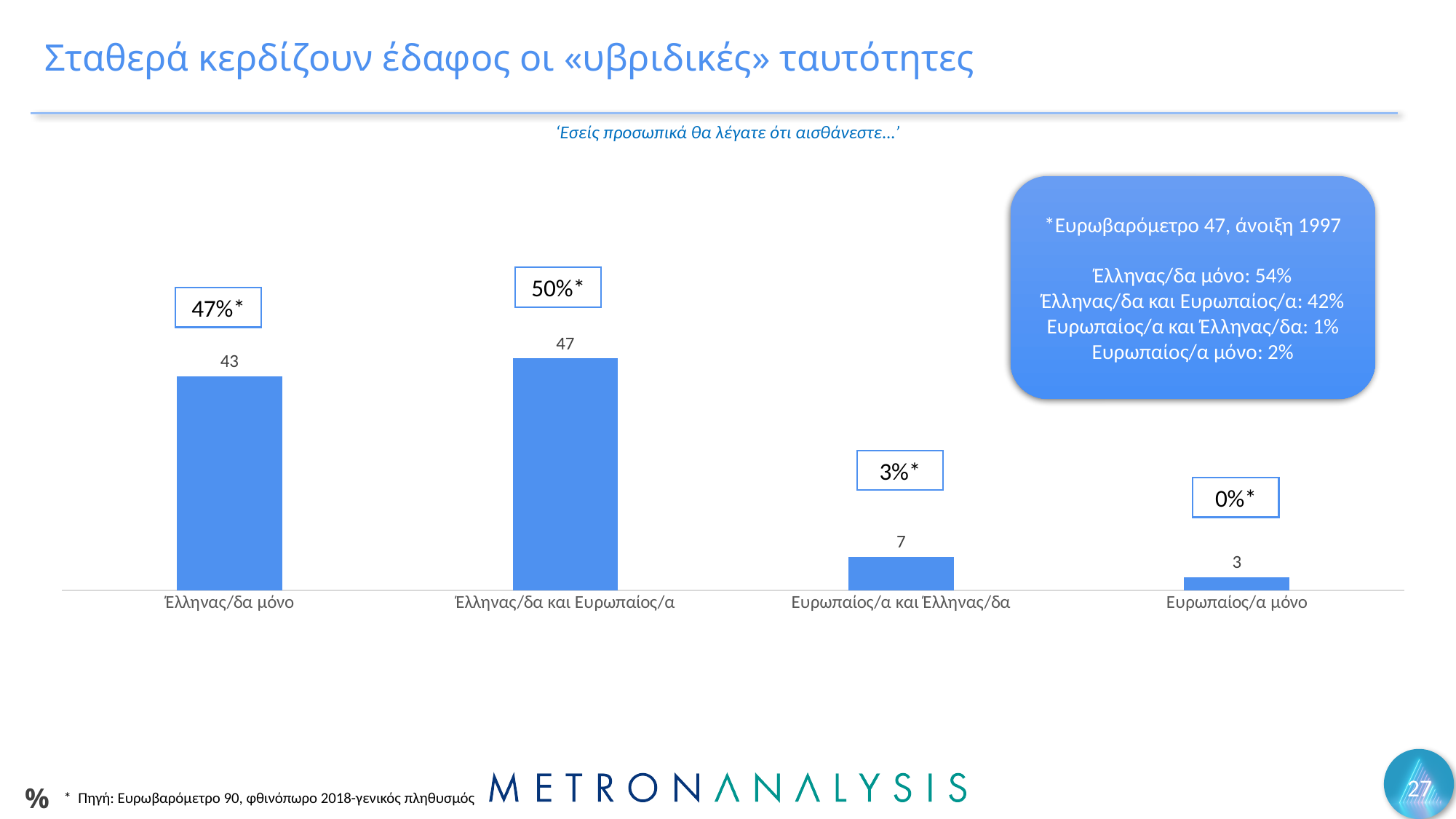
What is the difference between the values for Έλληνας/δα και Ευρωπαίος/α and Έλληνας/δα μόνο? 4 What is the starred label shown in the box above the bar for Έλληνας/δα και Ευρωπαίος/α? 50%* Which category has the highest value? Έλληνας/δα και Ευρωπαίος/α What is the value for Έλληνας/δα και Ευρωπαίος/α? 47 What is the value for Ευρωπαίος/α μόνο? 3 How many categories are shown on the x axis of the chart? 4 What is the value for Έλληνας/δα μόνο? 43 What colour are the bars in the chart? Blue Which category has the lowest value? Ευρωπαίος/α μόνο What kind of chart is shown on the slide? Bar chart What is the value for Ευρωπαίος/α και Έλληνας/δα? 7 Which is larger, the value for Ευρωπαίος/α και Έλληνας/δα or the value for Ευρωπαίος/α μόνο? Ευρωπαίος/α και Έλληνας/δα